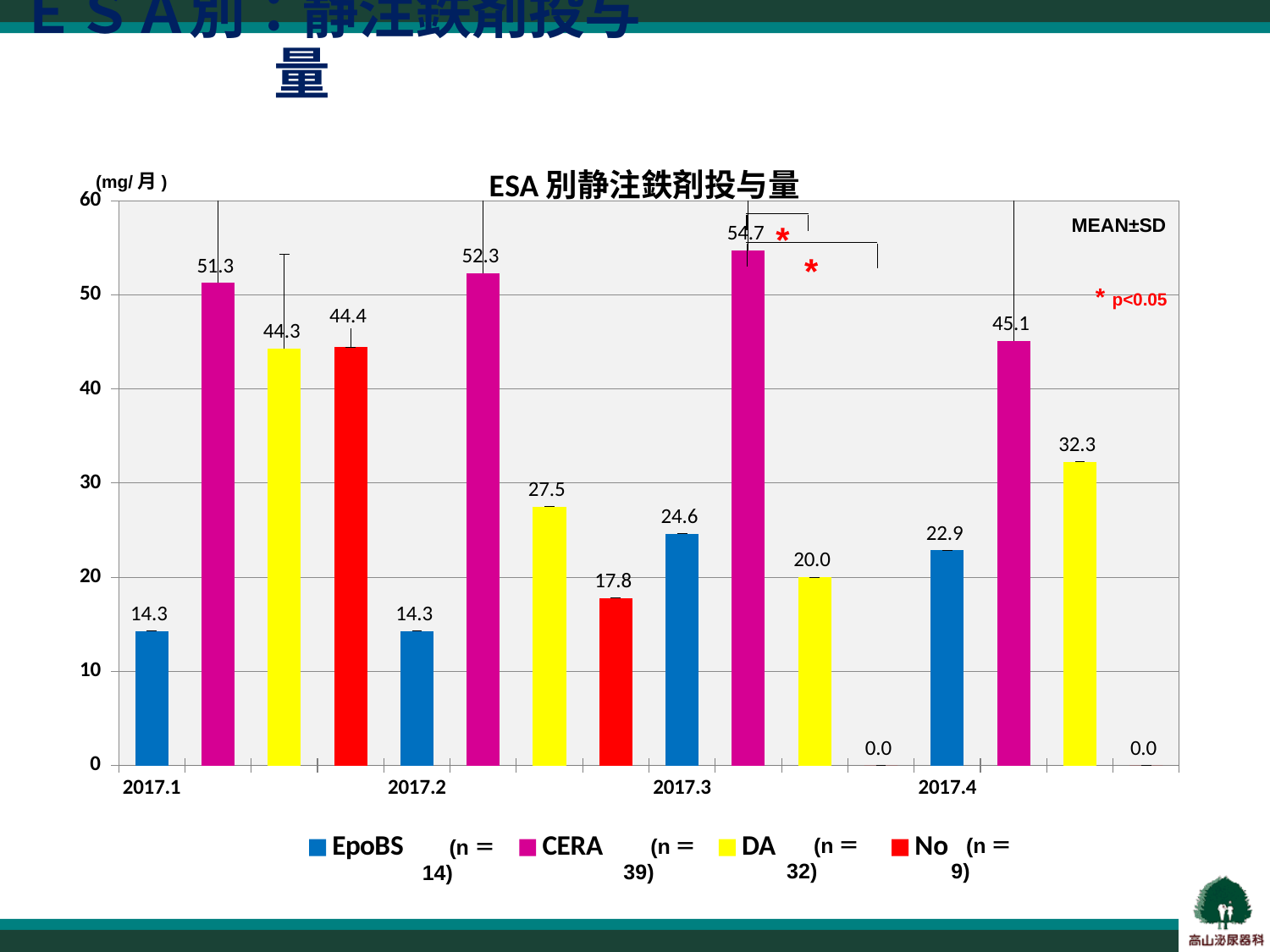
What is the value for No in 2017.1? 44.4 What is the difference between the CERA and EpoBS values in 2017.2? 38.0 In which period is the DA value lowest? 2017.3 What is the value for DA in 2017.2? 27.5 Which is larger in 2017.1, the DA value or the No value? No What is the value for EpoBS in 2017.4? 22.9 What is the value for CERA in 2017.3? 54.7 How many periods are shown on the x axis? 4 How many series does the legend list? 4 In which period is the CERA value highest? 2017.3 What unit is shown on the y axis? mg/月 What kind of chart is shown? Bar chart